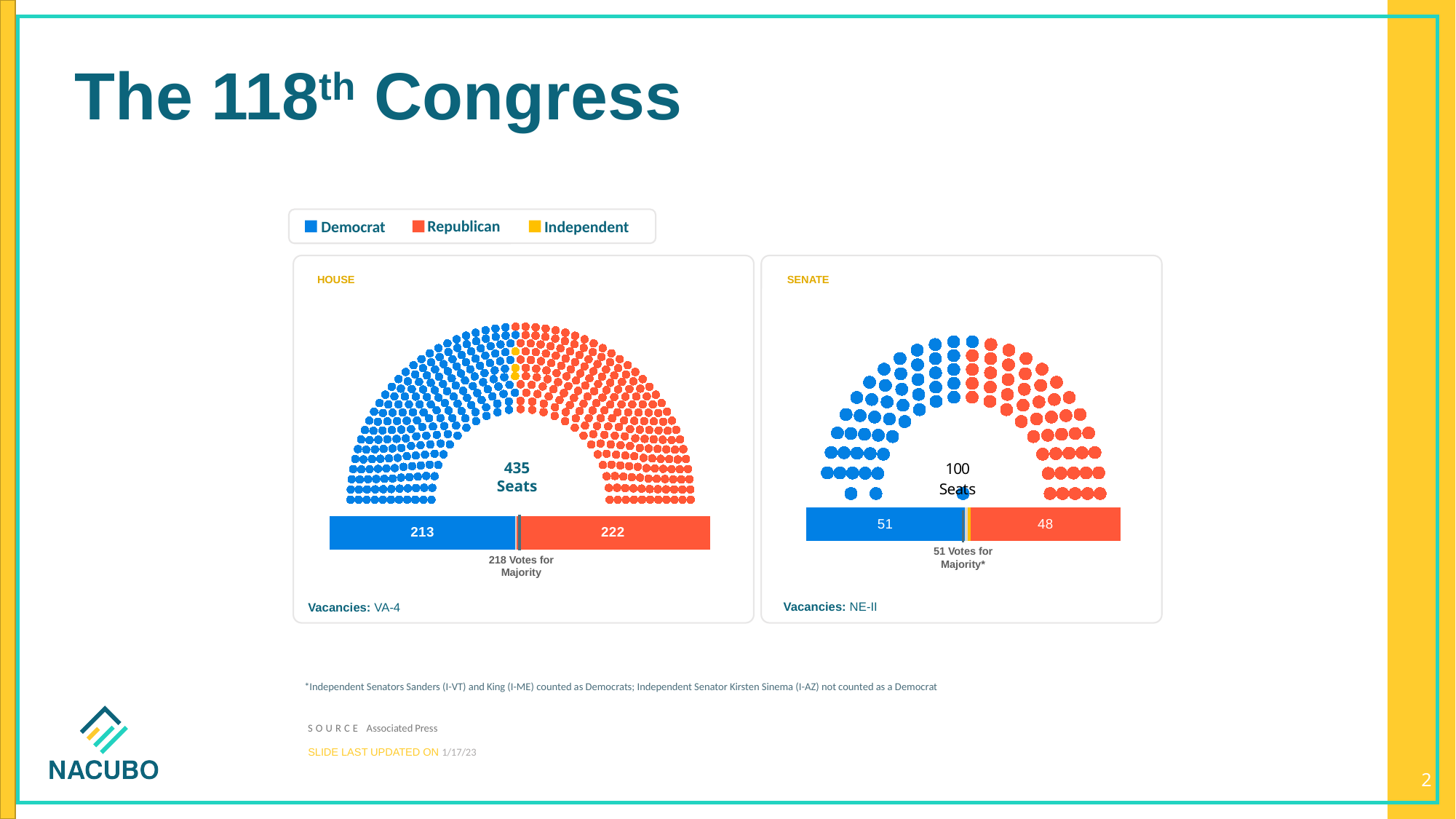
How many entries does the shared legend list? 3 What vacancy is listed under the Senate chart? NE-II In the Senate chart, how many seats do Democrats hold? 51 In the House chart, which party holds more seats, Democrats or Republicans? Republicans How many votes are needed for a majority according to the House chart? 218 How many total seats does the House chart show? 435 Seats In the Senate chart, which party holds more seats, Democrats or Republicans? Democrats In the House chart, how many seats do Republicans hold? 222 In the Senate chart, what is the difference between the Democrat and Republican seat counts? 3 In the House chart, what is the difference between the Republican and Democrat seat counts? 9 In the Senate chart, how many seats do Republicans hold? 48 In the House chart, how many seats do Democrats hold? 213